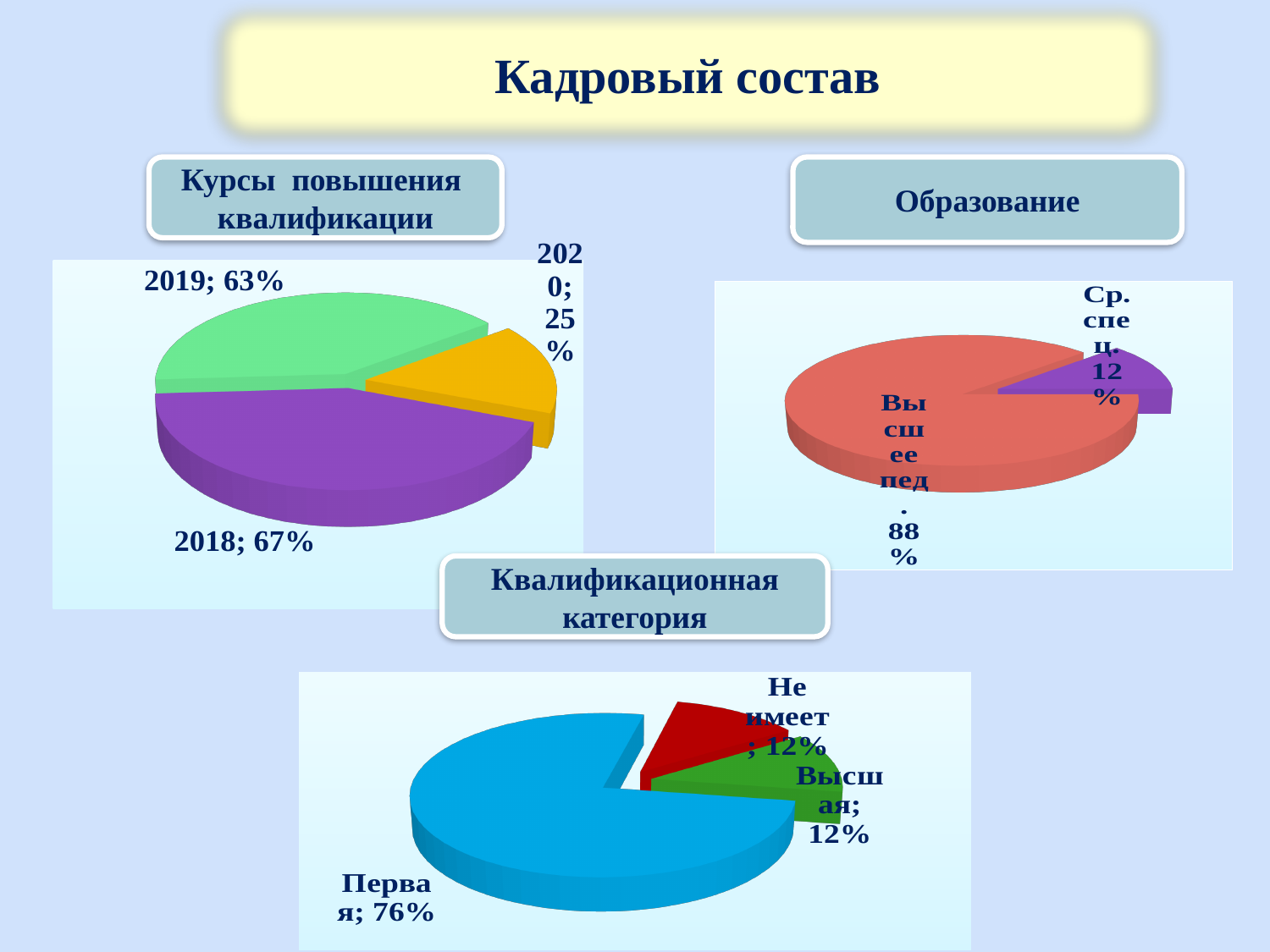
In the "Курсы повышения квалификации" chart, what value is shown for 2019? 63% In the "Курсы повышения квалификации" chart, which year has the smallest slice? 2020 In the "Квалификационная категория" chart, which category has the largest slice? Первая In the "Образование" chart, what is the difference between the "Высшее пед." and "Ср. спец." shares? 76% In the "Образование" chart, what share is shown for "Ср. спец."? 12% In the "Квалификационная категория" chart, what share is shown for "Не имеет"? 12% In the "Курсы повышения квалификации" chart, how many slices does the pie have? 3 In the "Курсы повышения квалификации" chart, what value is shown for 2020? 25% In the "Квалификационная категория" chart, what share is shown for "Первая"? 76% What type of chart is used for "Квалификационная категория"? Pie chart In the "Курсы повышения квалификации" chart, which year has the largest slice? 2018